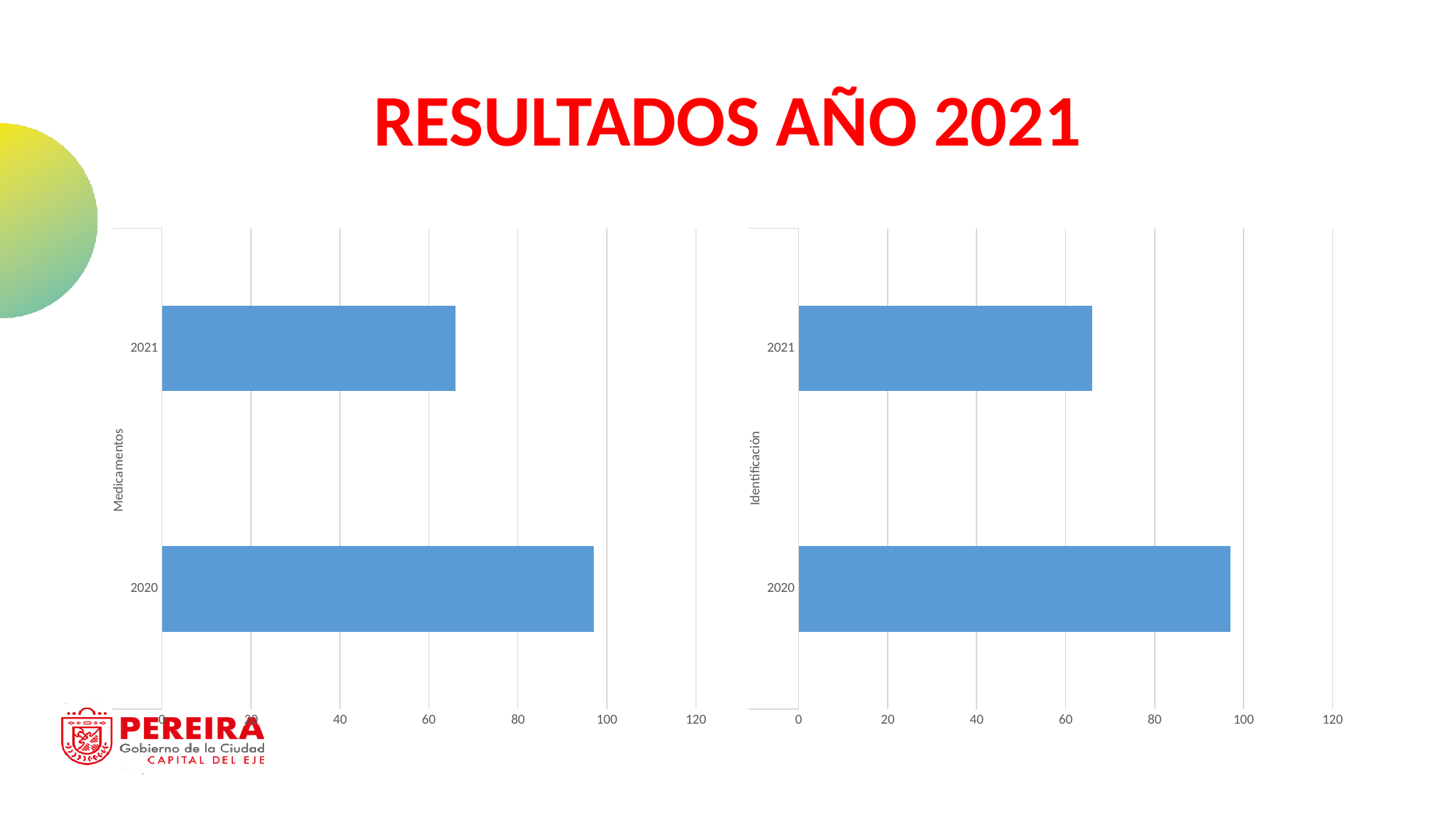
In the left chart (Medicamentos), is the value for 2020 greater or less than 80? greater What is the axis label on the right chart? Identificación How many bars does the left chart (Medicamentos) show? 2 In the left chart (Medicamentos), which year has the lower value? 2021 In the right chart (Identificación), is the value for 2021 greater or less than 60? greater What kind of chart is the left chart labelled Medicamentos? bar chart In the right chart (Identificación), which year has the higher value? 2020 In the left chart (Medicamentos), is the value for 2021 greater or less than 80? less In the right chart (Identificación), is the value for 2020 larger or smaller than the value for 2021? larger What is the highest tick value shown on the horizontal axis of the left chart (Medicamentos)? 120 In the left chart (Medicamentos), which year has the higher value? 2020